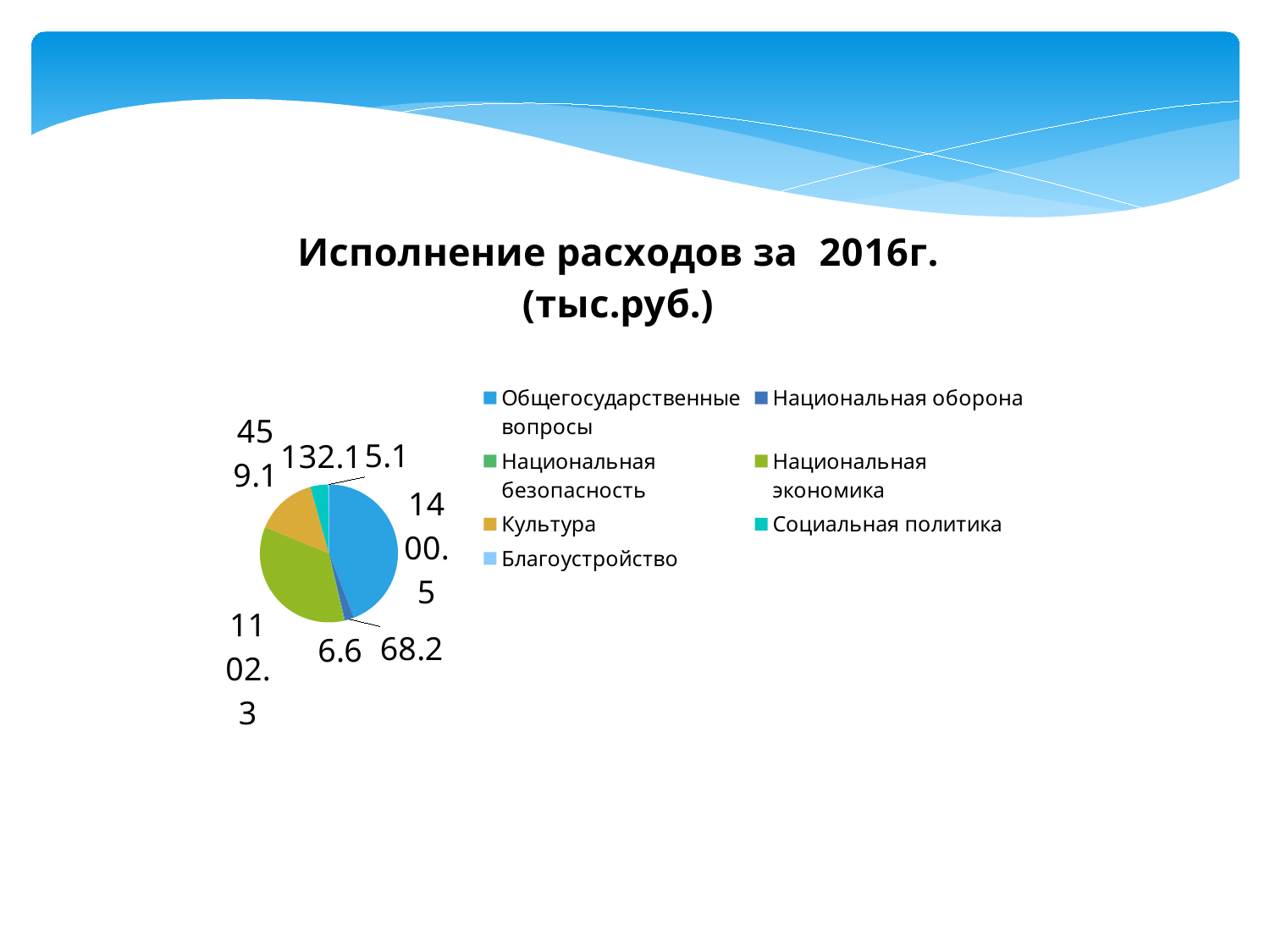
What is the value for Социальная политика in the pie chart? 132.1 Which category has the smallest value in the pie chart? Благоустройство What is the title of the chart on the slide? Исполнение расходов за 2016г. (тыс.руб.) Which category has the largest slice in the pie chart? Общегосударственные вопросы What is the value for Национальная оборона in the pie chart? 68.2 What is the value for Национальная экономика in the pie chart? 1102.3 How many categories does the legend of the pie chart list? 7 What is the value for Культура in the pie chart? 459.1 What is the difference between the values for Социальная политика and Национальная оборона? 63.9 What kind of chart is shown on the slide? Pie chart Which is larger, the value for Культура or the value for Социальная политика? Культура What is the difference between the values for Общегосударственные вопросы and Национальная экономика? 298.2